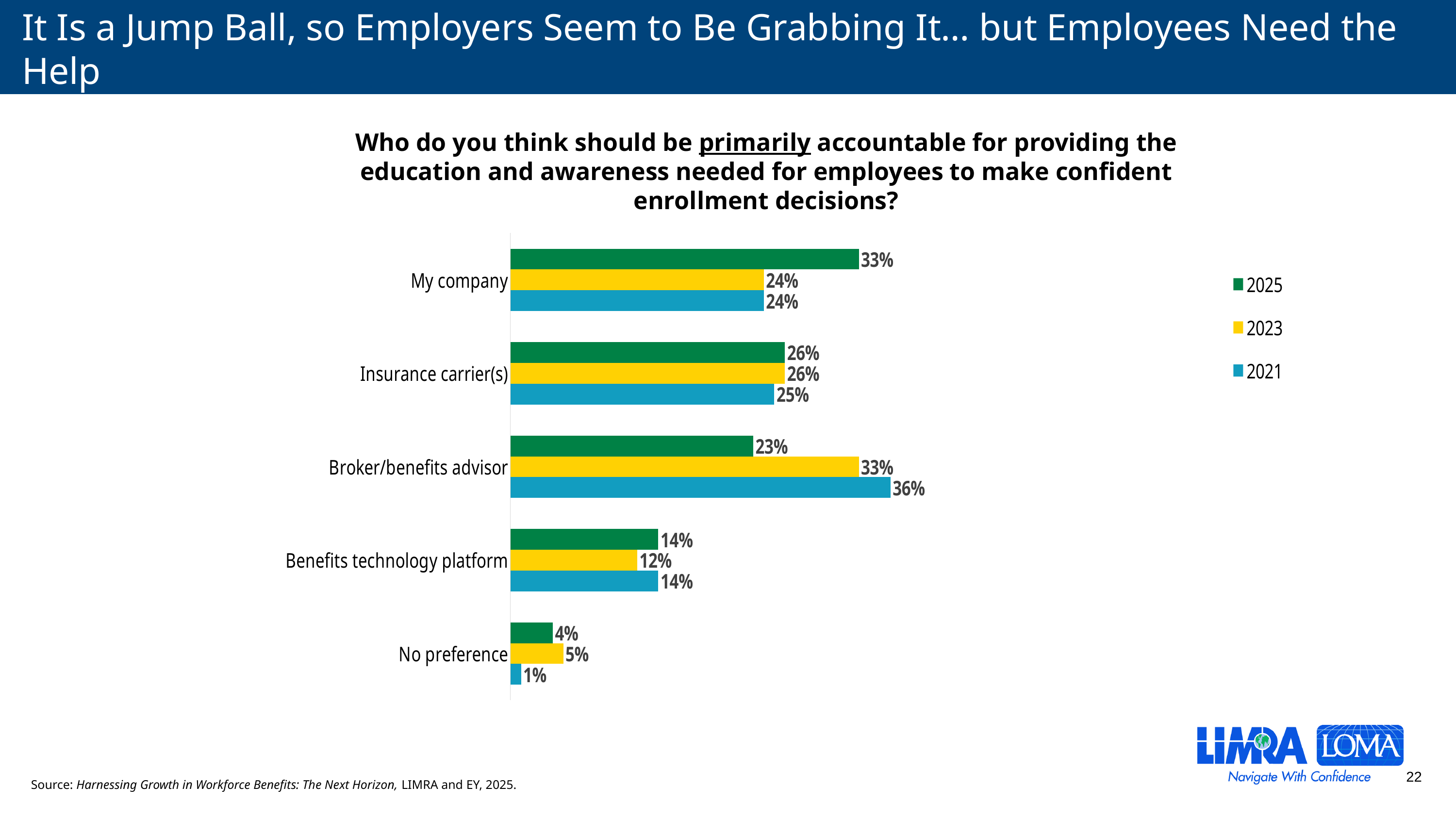
Which is larger for Insurance carrier(s): the 2025 value or the 2021 value? 2025 What is the 2023 value for Benefits technology platform? 12% How many categories are shown on the chart? 5 What is the 2021 value for No preference? 1% Which category has the lowest 2021 value? No preference What is the 2021 value for Broker/benefits advisor? 36% Which colour represents the 2023 series in the legend? Yellow What kind of chart is shown on the slide? Bar chart How many series does the legend list? 3 What is the difference between the 2021 and 2025 values for Broker/benefits advisor? 13% Which category has the highest 2025 value? My company What is the 2025 value for My company? 33%